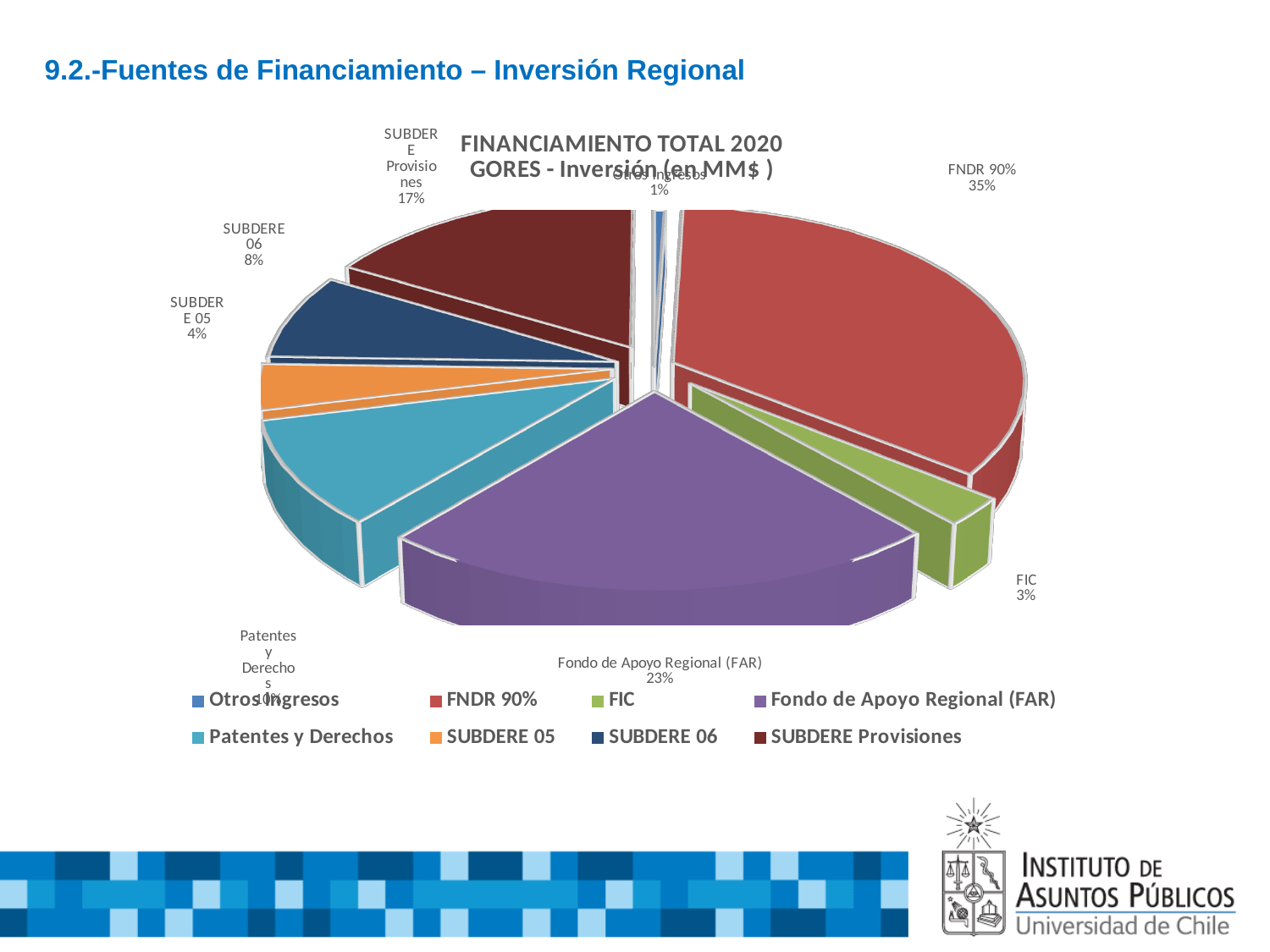
Which category has the largest share of the pie? FNDR 90% Which is larger, the share for Fondo de Apoyo Regional (FAR) or the share for SUBDERE Provisiones? Fondo de Apoyo Regional (FAR) What percentage is shown for SUBDERE Provisiones? 17% Which category has the smallest share of the pie? Otros Ingresos What kind of chart is shown on the slide? Pie chart How many categories does the legend list? 8 By how many percentage points does the FNDR 90% share exceed the Fondo de Apoyo Regional (FAR) share? 12 percentage points What percentage is shown for SUBDERE 06? 8% What share of the pie does Fondo de Apoyo Regional (FAR) represent? 23% What is the title of the chart? FINANCIAMIENTO TOTAL 2020 GORES - Inversión (en MM$ ) What percentage is shown for SUBDERE 05? 4% What percentage is shown for FIC? 3%